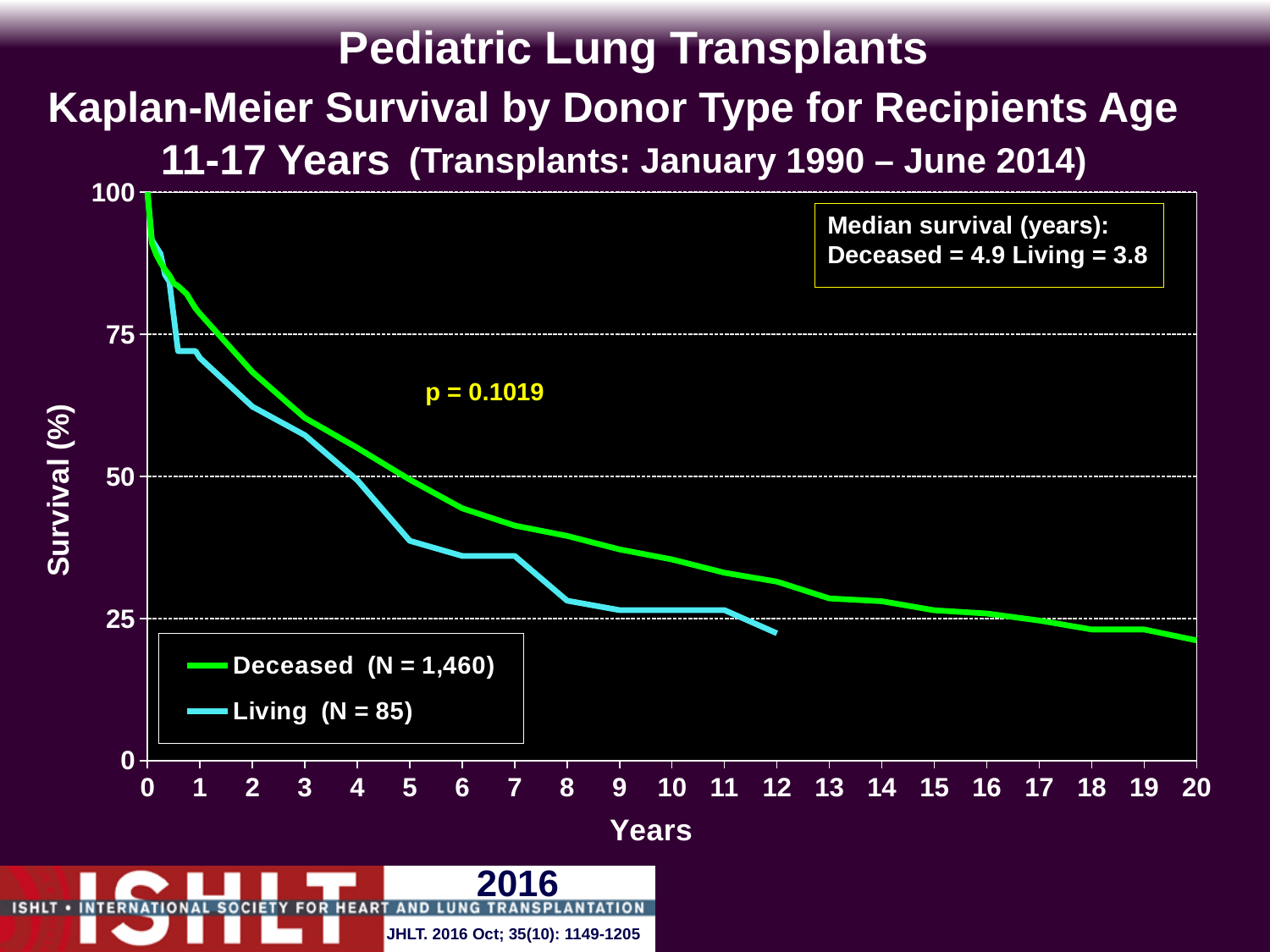
What median survival in years is given for the Living donor type? 3.8 Is the survival value for the Deceased series at 10 years greater or less than 25? greater How many series does the legend list? 2 At 5 years, which series has the higher survival, Deceased or Living? Deceased Is the survival value for the Living series at 3 years greater or less than 50? greater Is the survival value for the Deceased series at 1 year greater or less than 75? greater At 8 years, which series has the lower survival, Deceased or Living? Living What is the N shown in the legend for the Deceased series? 1,460 Do the survival curves rise or fall as the years increase along the x axis? fall What kind of chart is shown on the slide? line chart